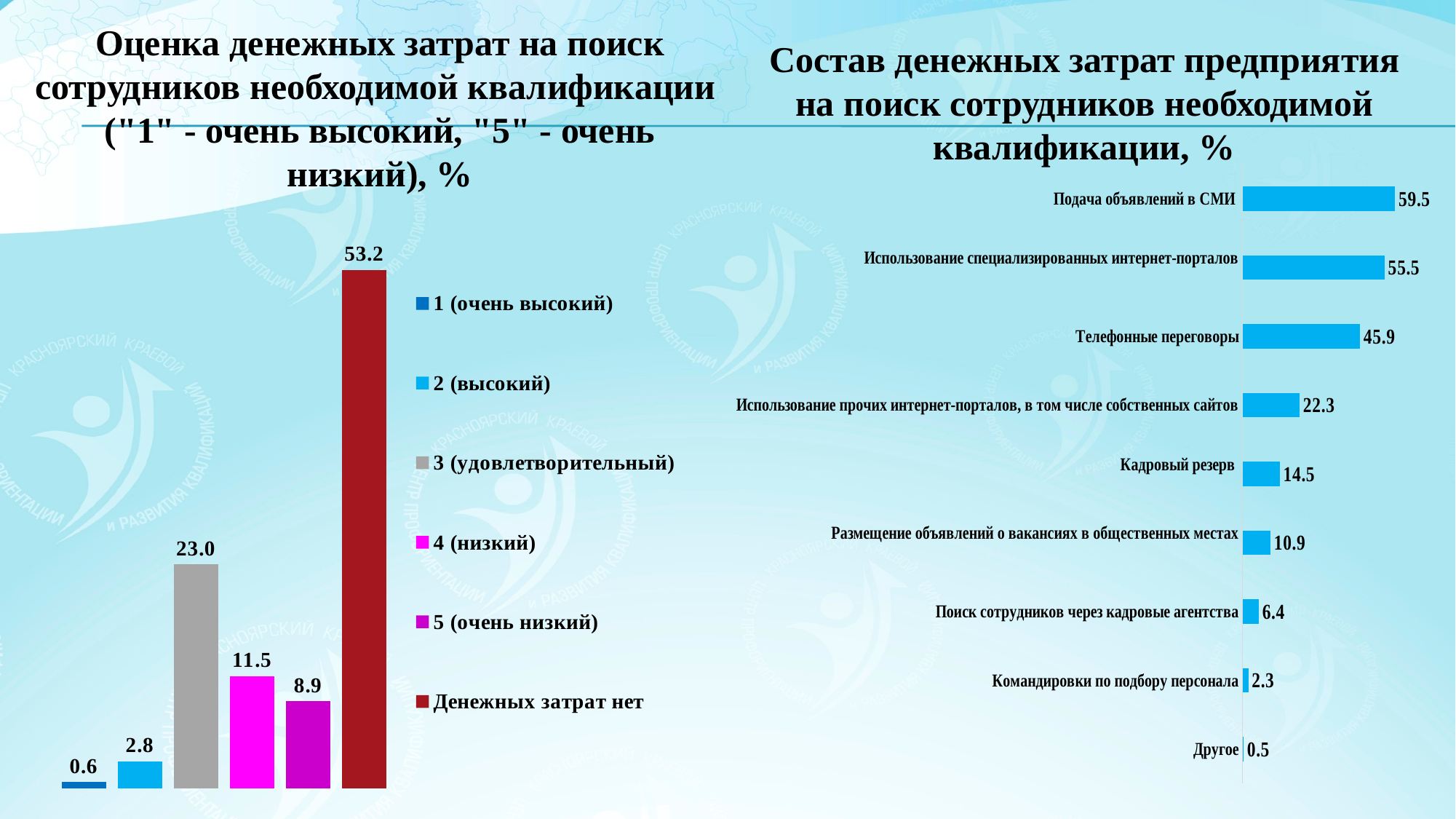
In the right chart (Состав денежных затрат предприятия), what is the value for "Телефонные переговоры"? 45.9 In the left chart (Оценка денежных затрат на поиск сотрудников), how many entries does the legend list? 6 In the left chart (Оценка денежных затрат на поиск сотрудников), what is the value for "Денежных затрат нет"? 53.2 In the right chart (Состав денежных затрат предприятия), which category has the highest value? Подача объявлений в СМИ In the right chart (Состав денежных затрат предприятия), which is larger: "Кадровый резерв" or "Поиск сотрудников через кадровые агентства"? Кадровый резерв In the left chart (Оценка денежных затрат на поиск сотрудников), what is the difference between "4 (низкий)" and "5 (очень низкий)"? 2.6 In the right chart (Состав денежных затрат предприятия), which category has the lowest value? Другое In the left chart (Оценка денежных затрат на поиск сотрудников), what colour is the bar for "Денежных затрат нет"? Dark red In the left chart (Оценка денежных затрат на поиск сотрудников), what is the value for "3 (удовлетворительный)"? 23.0 In the right chart (Состав денежных затрат предприятия), how many categories are shown? 9 In the left chart (Оценка денежных затрат на поиск сотрудников), which category has the lowest value? 1 (очень высокий) In the right chart (Состав денежных затрат предприятия), what is the difference between "Подача объявлений в СМИ" and "Использование специализированных интернет-порталов"? 4.0